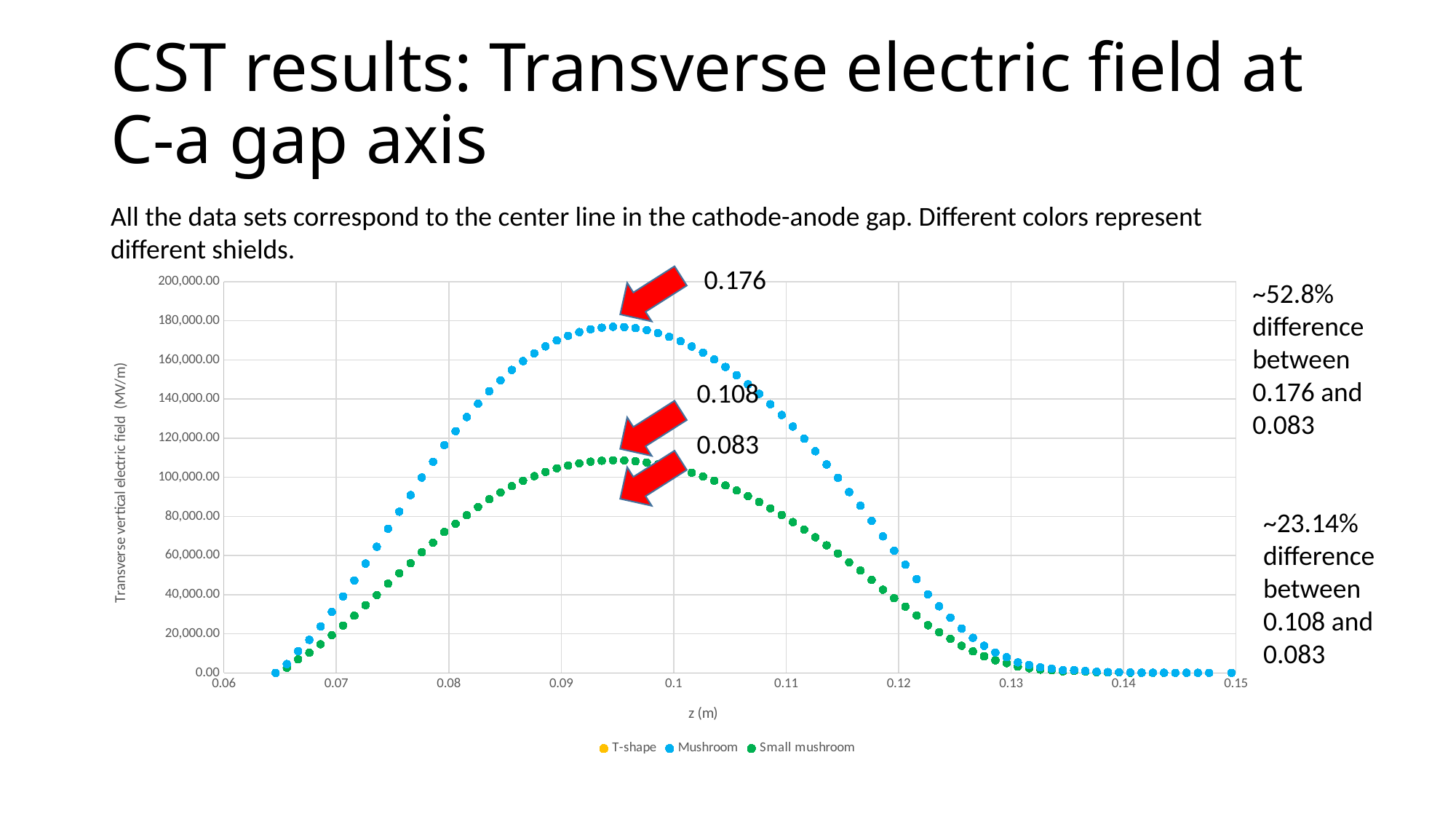
What are the three series named in the chart legend? T-shape, Mushroom, Small mushroom What is the label of the x axis of the chart? z (m) Is the value of the Small mushroom series at z = 0.13 greater or less than 20,000.00? less What is the maximum value shown on the y axis of the chart? 200,000.00 According to the annotation on the slide, what is the percentage difference between 0.176 and 0.083? ~52.8% How many series does the chart legend list? 3 Is the peak value of the Mushroom series greater or less than 160,000.00? greater What kind of chart is shown on the slide? scatter chart Is the peak value of the Small mushroom series greater or less than 120,000.00? less How do the values of the Mushroom series change as z increases from 0.06 to 0.15? rise to a peak near z = 0.095, then fall Which series reaches the higher peak value, Mushroom or Small mushroom? Mushroom